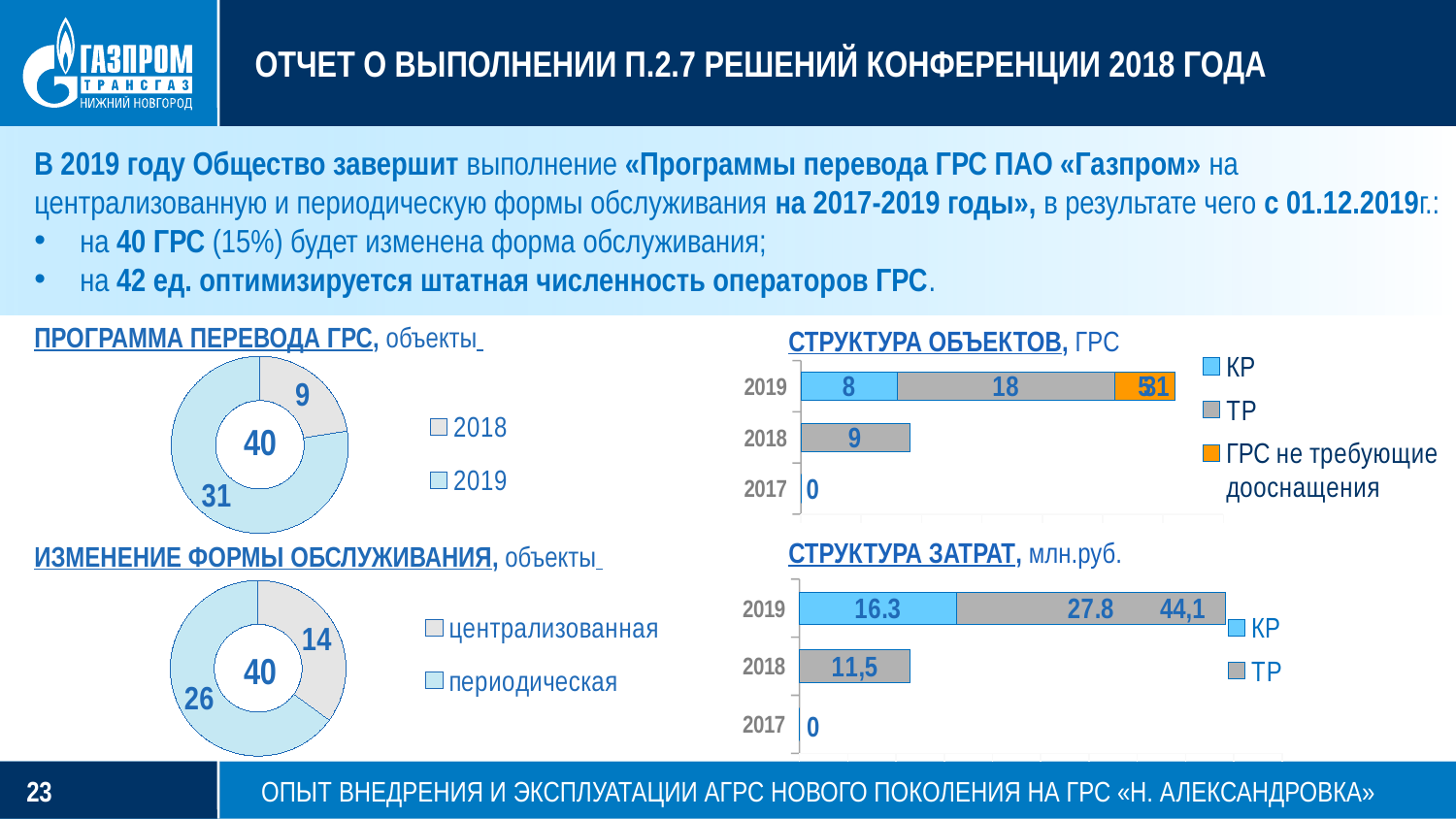
In the donut chart titled «ИЗМЕНЕНИЕ ФОРМЫ ОБСЛУЖИВАНИЯ, объекты», which segment is larger, «централизованная» or «периодическая»? периодическая In the chart titled «СТРУКТУРА ОБЪЕКТОВ, ГРС», what is the КР value for 2019? 8 In the donut chart titled «ПРОГРАММА ПЕРЕВОДА ГРС, объекты», what is the difference between the 2019 and 2018 values? 22 What kind of chart is the one titled «СТРУКТУРА ЗАТРАТ, млн.руб.»? bar chart In the donut chart titled «ИЗМЕНЕНИЕ ФОРМЫ ОБСЛУЖИВАНИЯ, объекты», what is the value for «централизованная»? 14 In the donut chart titled «ИЗМЕНЕНИЕ ФОРМЫ ОБСЛУЖИВАНИЯ, объекты», what share of the total of 40 does «периодическая» (26) represent? 65% In the chart titled «СТРУКТУРА ОБЪЕКТОВ, ГРС», what is the ТР value for 2019? 18 In the donut chart titled «ПРОГРАММА ПЕРЕВОДА ГРС, объекты», what is the value for 2018? 9 In the chart titled «СТРУКТУРА ЗАТРАТ, млн.руб.», what is the value for 2018? 11,5 In the donut chart titled «ПРОГРАММА ПЕРЕВОДА ГРС, объекты», what is the value for 2019? 31 In the chart titled «СТРУКТУРА ЗАТРАТ, млн.руб.», what is the ТР value for 2019? 27.8 How many series does the legend of the chart titled «СТРУКТУРА ОБЪЕКТОВ, ГРС» list? 3